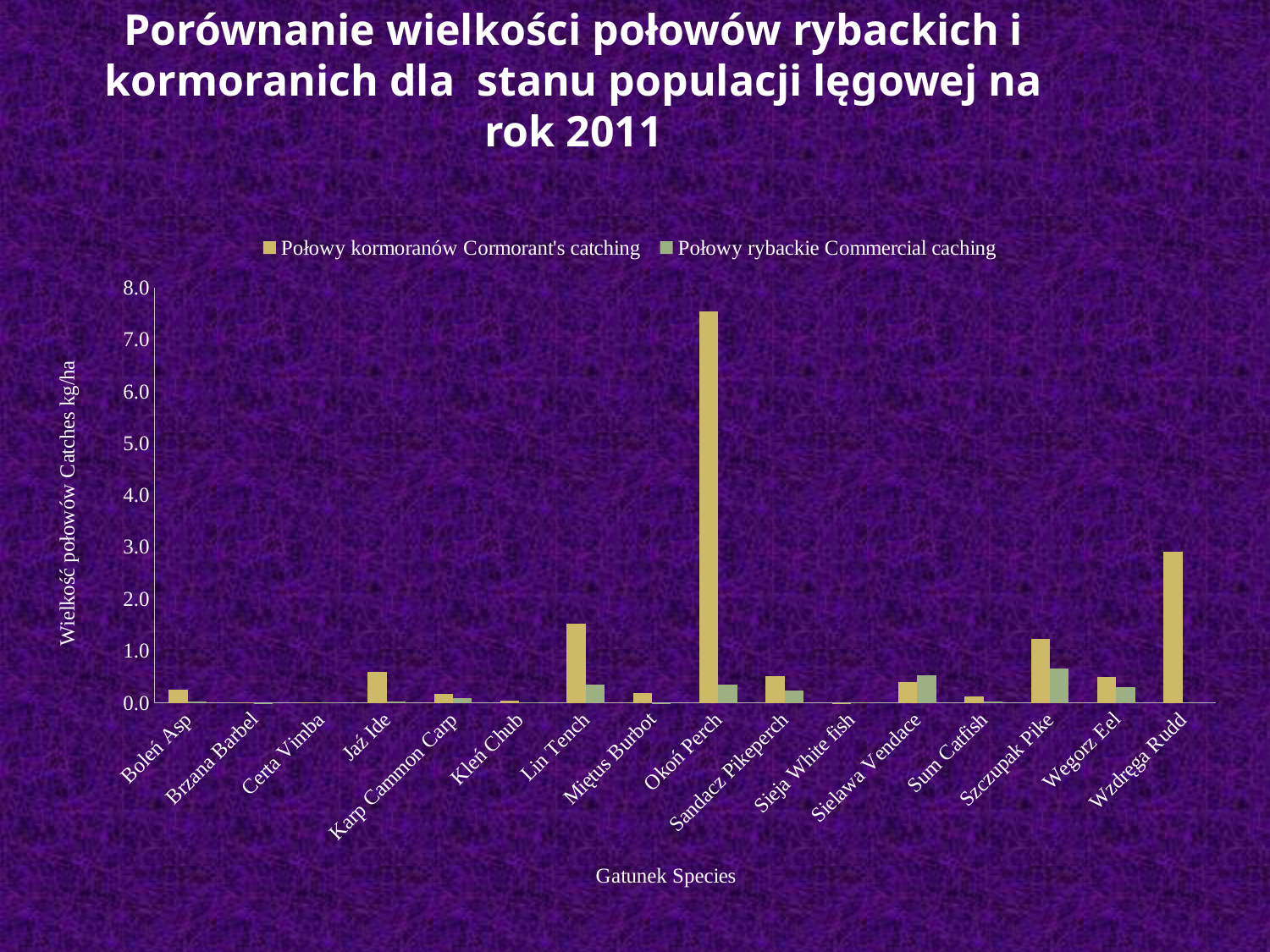
Which species has the highest value for Połowy kormoranów Cormorant's catching? Okoń Perch Is the Cormorant's catching value for Wzdręga Rudd greater or less than 2.0? greater Is the Cormorant's catching value for Lin Tench greater or less than 1.0? greater Is the Cormorant's catching value for Okoń Perch greater or less than 7.0? greater What kind of chart is shown on the slide? bar chart What is the title of the x axis? Gatunek Species For Wzdręga Rudd, which is larger: Cormorant's catching or Commercial caching? Cormorant's catching What is the title of the y axis? Wielkość połowów Catches kg/ha How many series does the legend list? 2 For Okoń Perch, which is larger: Cormorant's catching or Commercial caching? Cormorant's catching How many species categories are shown on the x axis? 16